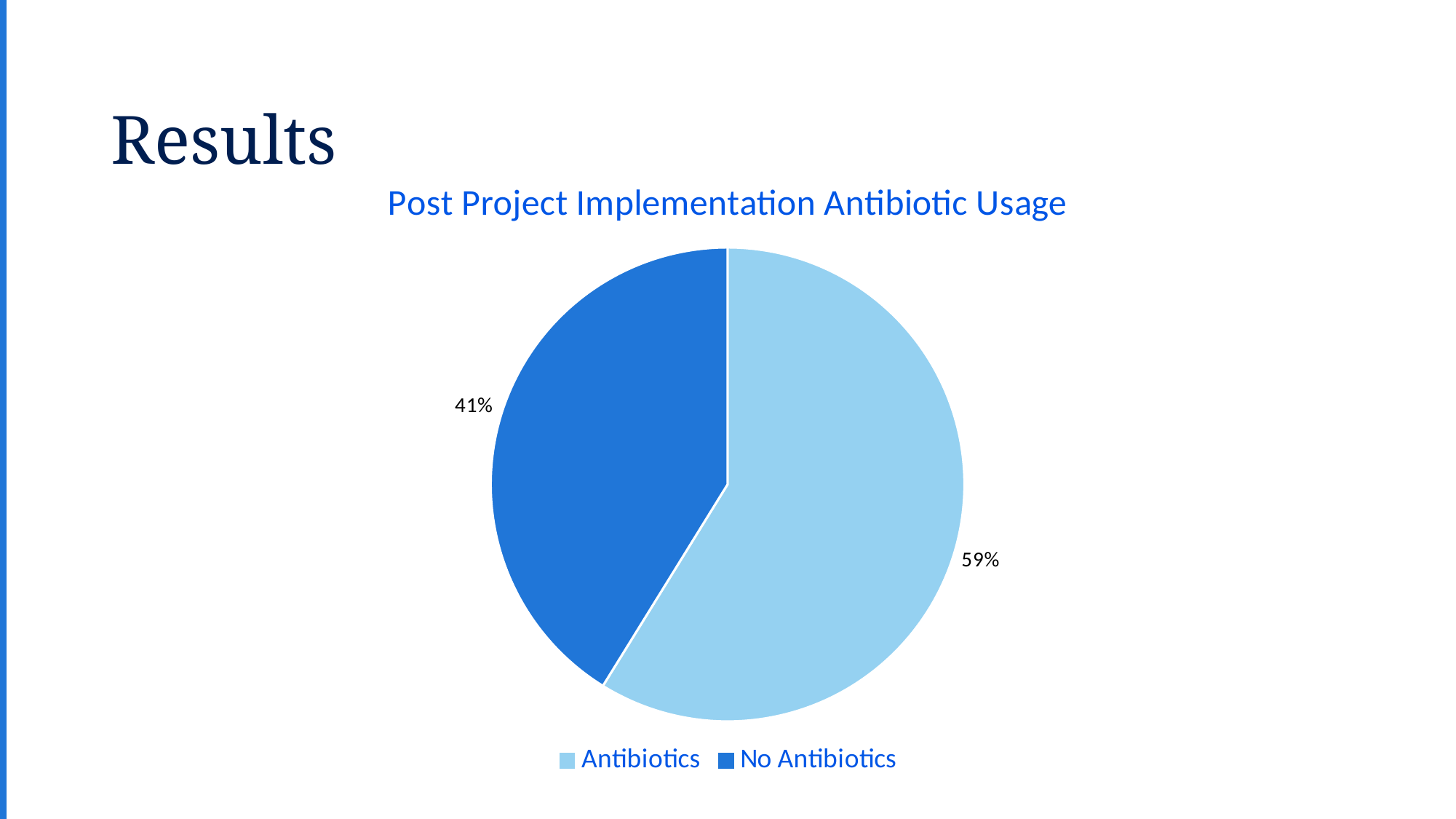
How many slices does the pie chart have? 2 How many entries does the legend list? 2 Which legend entry is shown in the darker blue colour? No Antibiotics Which is larger, the Antibiotics slice or the No Antibiotics slice? Antibiotics What percentage of the pie is labelled No Antibiotics? 41% Which slice is the smallest? No Antibiotics What is the difference in percentage points between the Antibiotics and No Antibiotics slices? 18 What share of the pie does the No Antibiotics slice represent? 41% Which slice is the largest? Antibiotics What kind of chart is shown on the slide? Pie chart What is the title of the chart? Post Project Implementation Antibiotic Usage What percentage of the pie is labelled Antibiotics? 59%